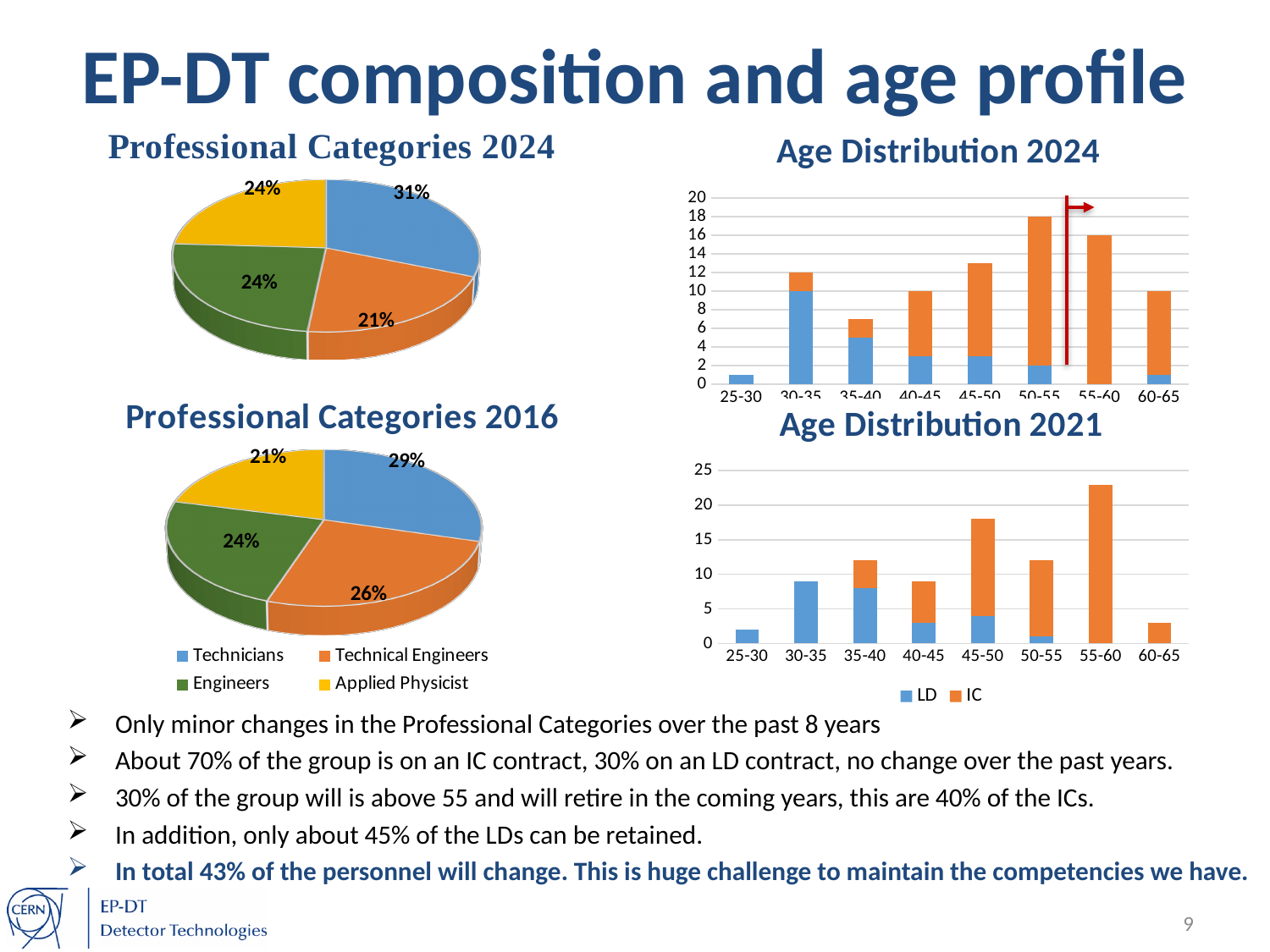
In the Professional Categories 2016 pie chart, what share do Technical Engineers have? 26% In the Age Distribution 2024 chart, is the total value for 55-60 greater or less than 14? greater What kind of chart is the Professional Categories 2016 chart? Pie chart In the Professional Categories 2024 pie chart, what is the share of the smallest slice? 21% How many series does the legend of the Age Distribution 2021 chart list? 2 In the Age Distribution 2021 chart, which age group has the tallest bar? 55-60 In the Professional Categories 2016 pie chart, what is the difference between the Technicians share and the Applied Physicist share? 8% In the Age Distribution 2024 chart, which age group has the shortest bar? 25-30 How many categories does the legend of the Professional Categories 2016 chart list? 4 In the Professional Categories 2016 pie chart, what share do Technicians have? 29% In the Age Distribution 2024 chart, which age group has the tallest bar? 50-55 In the Professional Categories 2024 pie chart, what share does the largest slice have? 31%